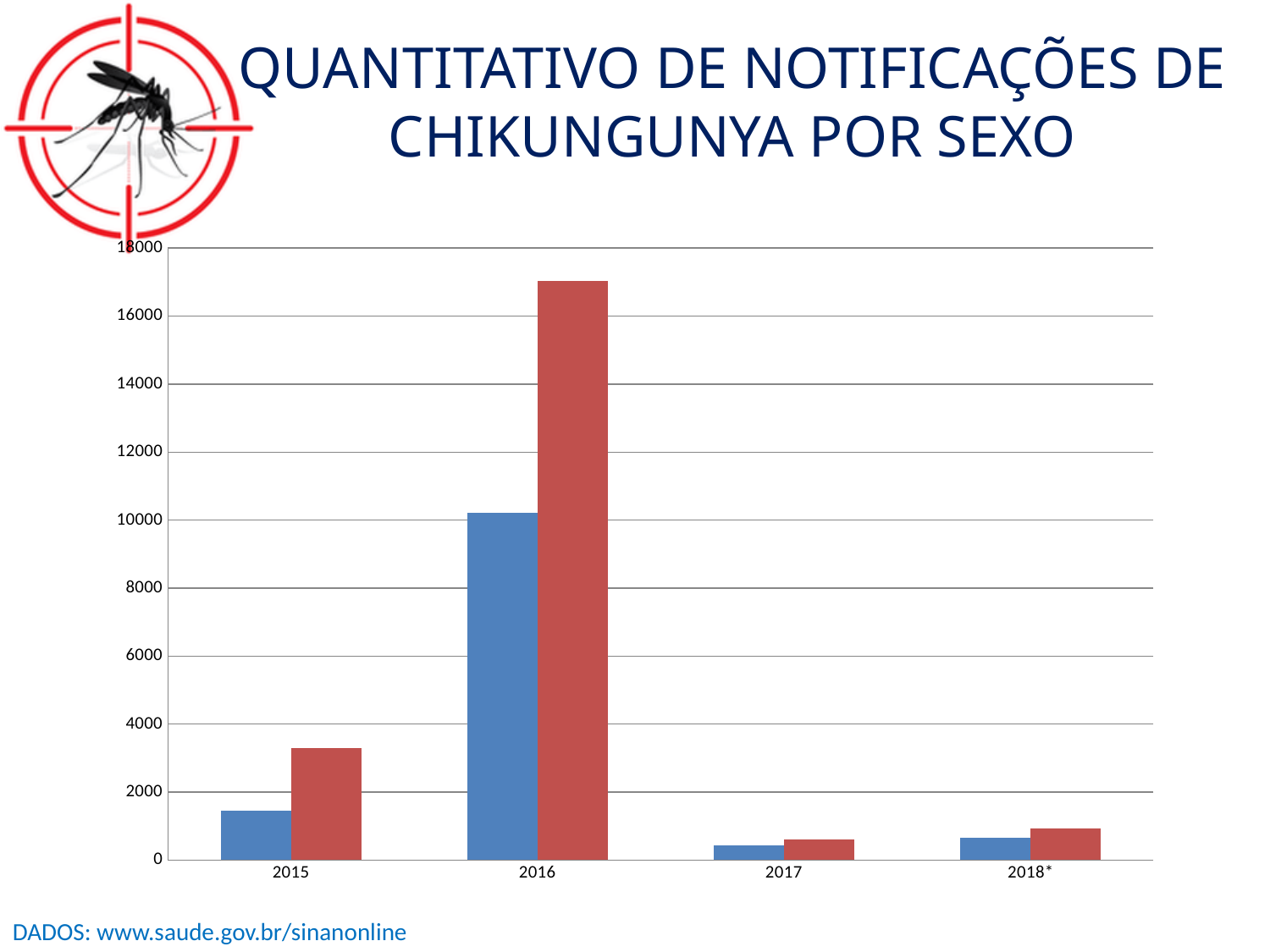
How many categories (years) are shown on the x axis? 4 Which year has the shortest blue bar? 2017 What kind of chart is shown on the slide? bar chart Which year has the tallest red bar? 2016 Do the red bars rise or fall from 2016 to 2017? fall Is the value of the red bar for 2015 greater or less than 4000? less In 2016, which bar is taller, the blue bar or the red bar? the red bar Which year has the tallest blue bar? 2016 What is the title of the slide? QUANTITATIVO DE NOTIFICAÇÕES DE CHIKUNGUNYA POR SEXO Is the value of the blue bar for 2015 greater or less than 2000? less Is the value of the red bar for 2016 greater or less than 16000? greater